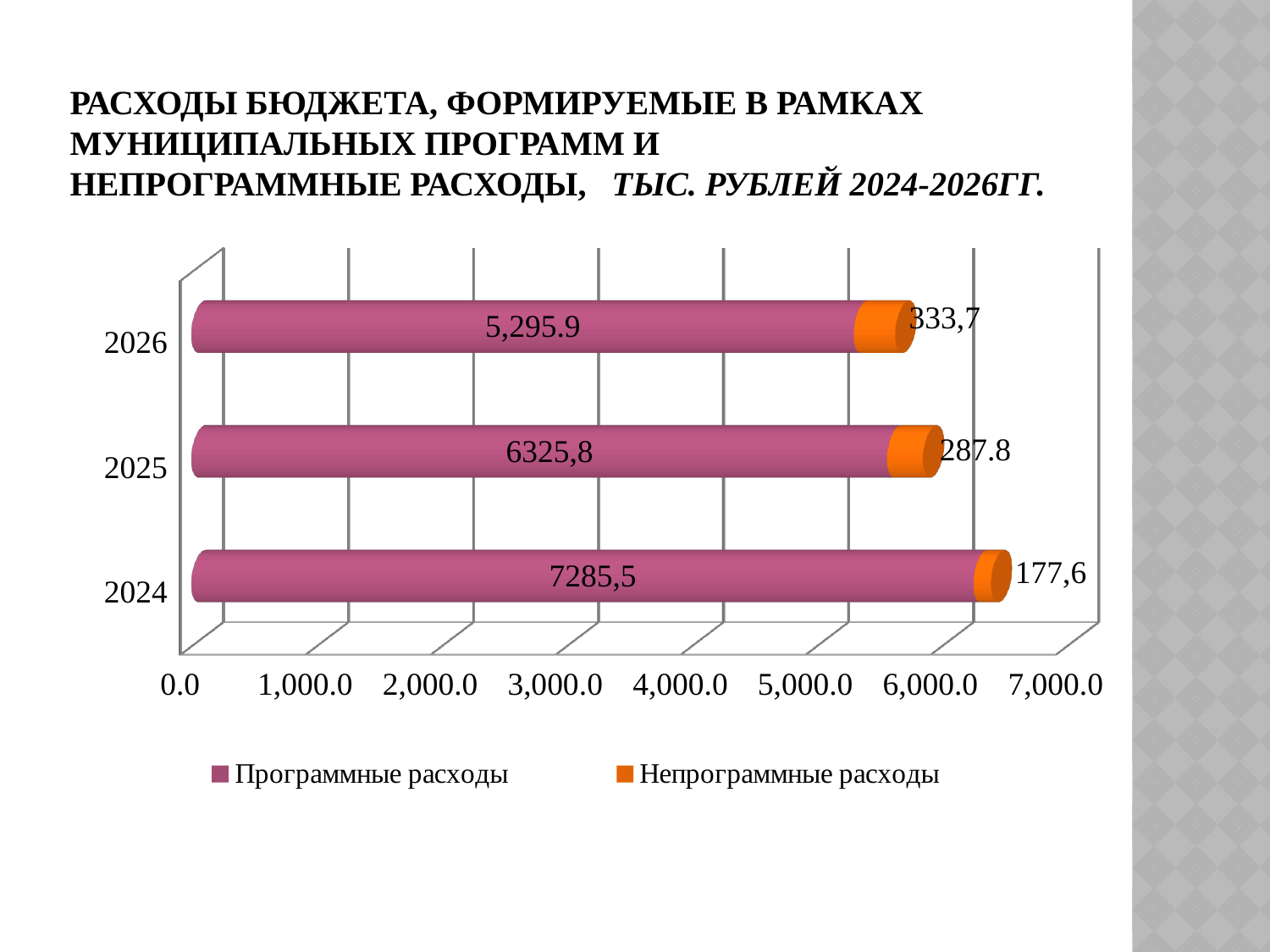
What is the value of Программные расходы for 2024? 7285,5 In which year are Программные расходы the highest? 2024 How many years are shown on the chart? 3 What kind of chart is shown on the slide? Bar chart Which year has larger Программные расходы, 2025 or 2026? 2025 What is the value of Непрограммные расходы for 2026? 333,7 What is the value of Непрограммные расходы for 2025? 287.8 In which year are Непрограммные расходы the lowest? 2024 Do Непрограммные расходы rise or fall from 2024 to 2026? Rise Which series is shown in orange? Непрограммные расходы How many series does the legend list? 2 What is the value of Программные расходы for 2025? 6325,8